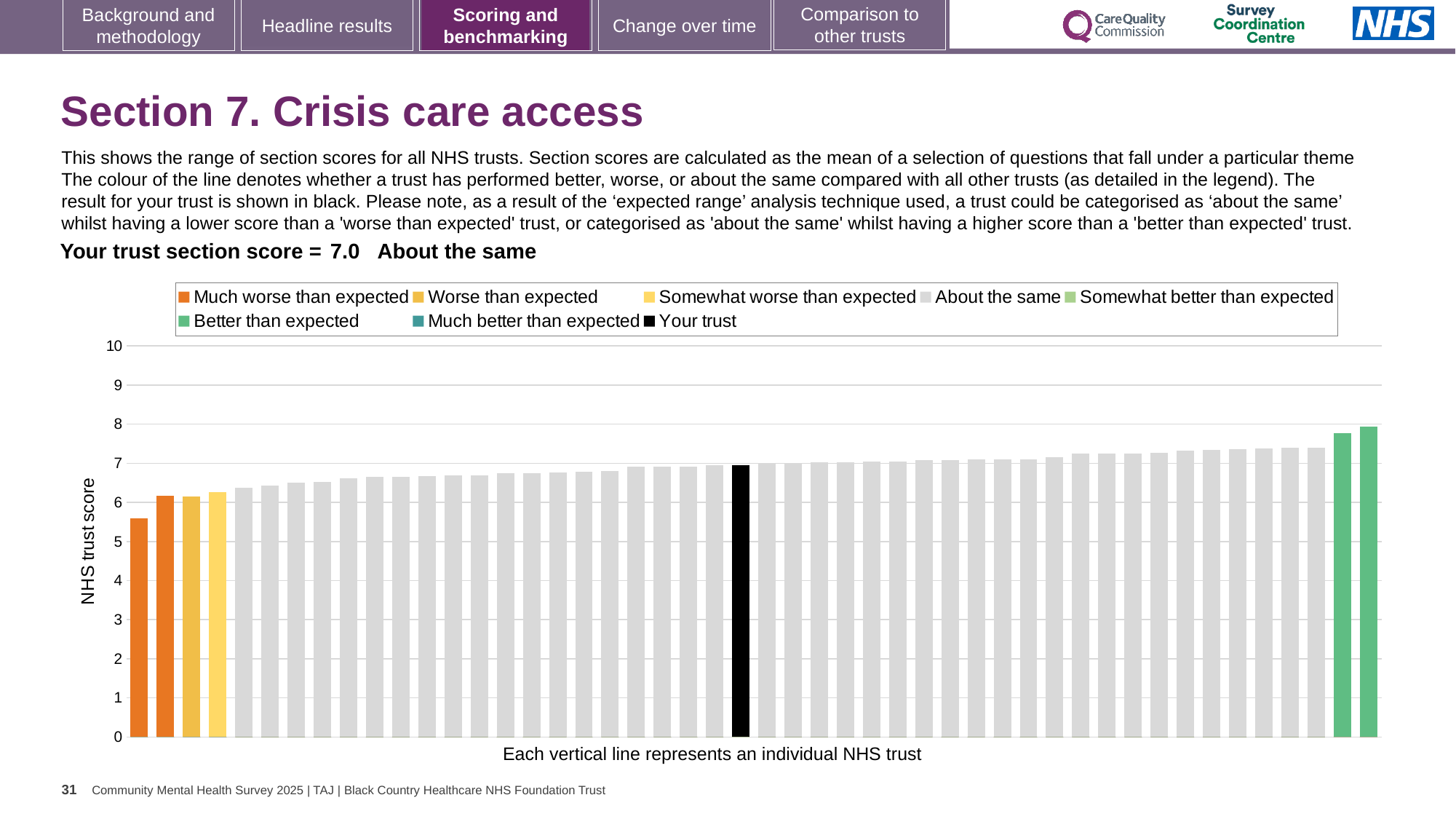
Is the value of the lowest bar in the chart greater or less than 6? less Do the bar values rise or fall moving from left to right along the x axis? rise What is the label on the vertical axis of the chart? NHS trust score What is the section score for your trust shown on the slide? 7.0 Which performance category is your trust placed in for crisis care access? About the same Is the value of the highest bar in the chart greater or less than 7? greater How many entries does the chart legend list? 8 Is the value of the black bar (your trust) greater or less than 8? less What type of chart is shown on the slide? bar chart How many green bars are shown at the right end of the chart? 2 What colour is the bar representing your trust? black How many orange bars are shown at the left end of the chart? 2